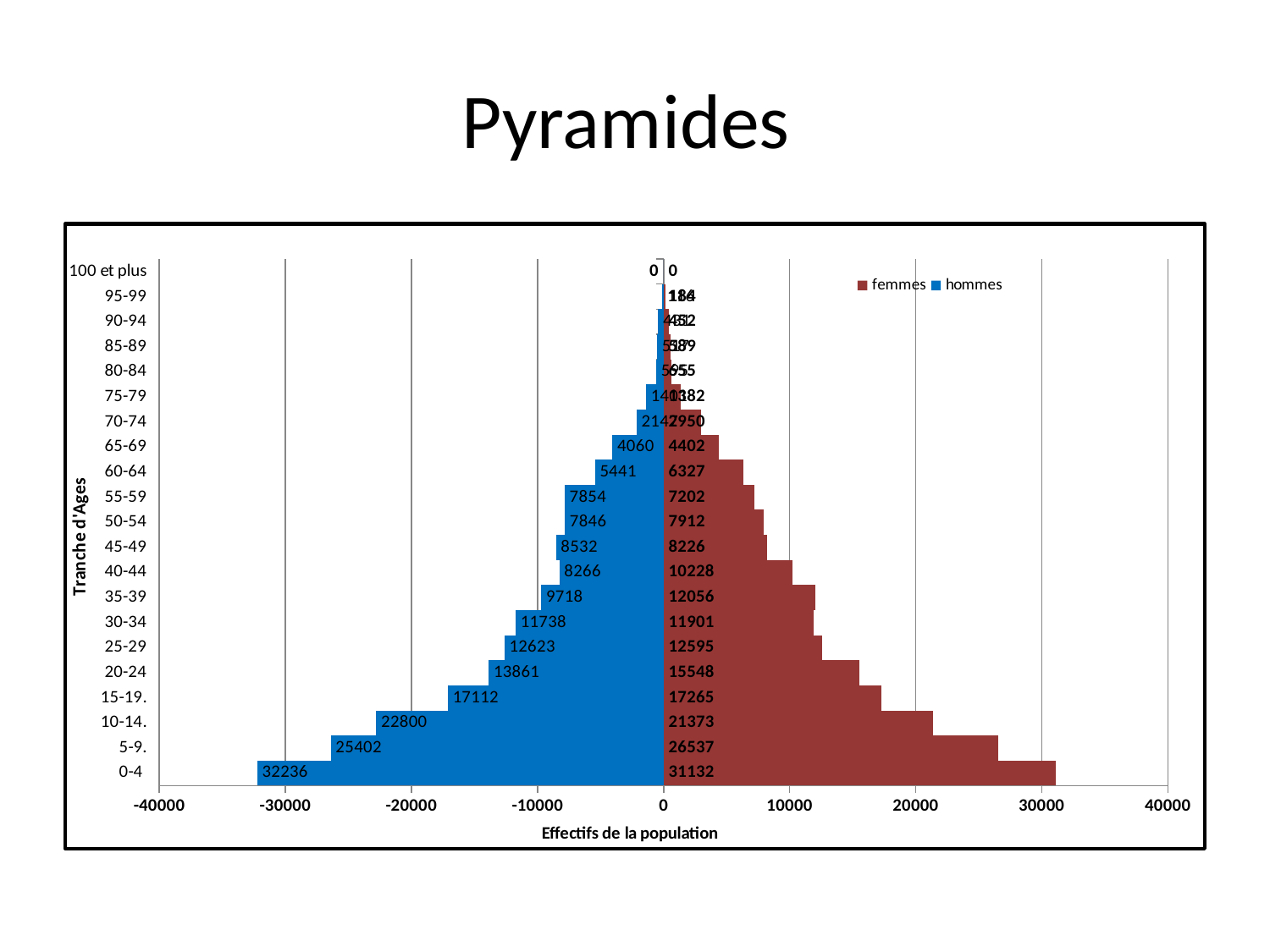
What is the value for femmes in the 0-4 age group? 31132 What is the value for femmes in the 20-24 age group? 15548 How many series does the legend list? 2 In the 0-4 age group, which series has the larger value, hommes or femmes? hommes What is the difference between the femmes and hommes values in the 5-9 age group? 1135 Which age group has the highest value for femmes? 0-4 What is the value for hommes in the 0-4 age group? 32236 What is the title of the horizontal axis? Effectifs de la population What is the value for hommes in the 10-14 age group? 22800 What kind of chart is shown on the slide? bar chart In the 35-39 age group, which series has the larger value, hommes or femmes? femmes What is the difference between the femmes and hommes values in the 40-44 age group? 1962